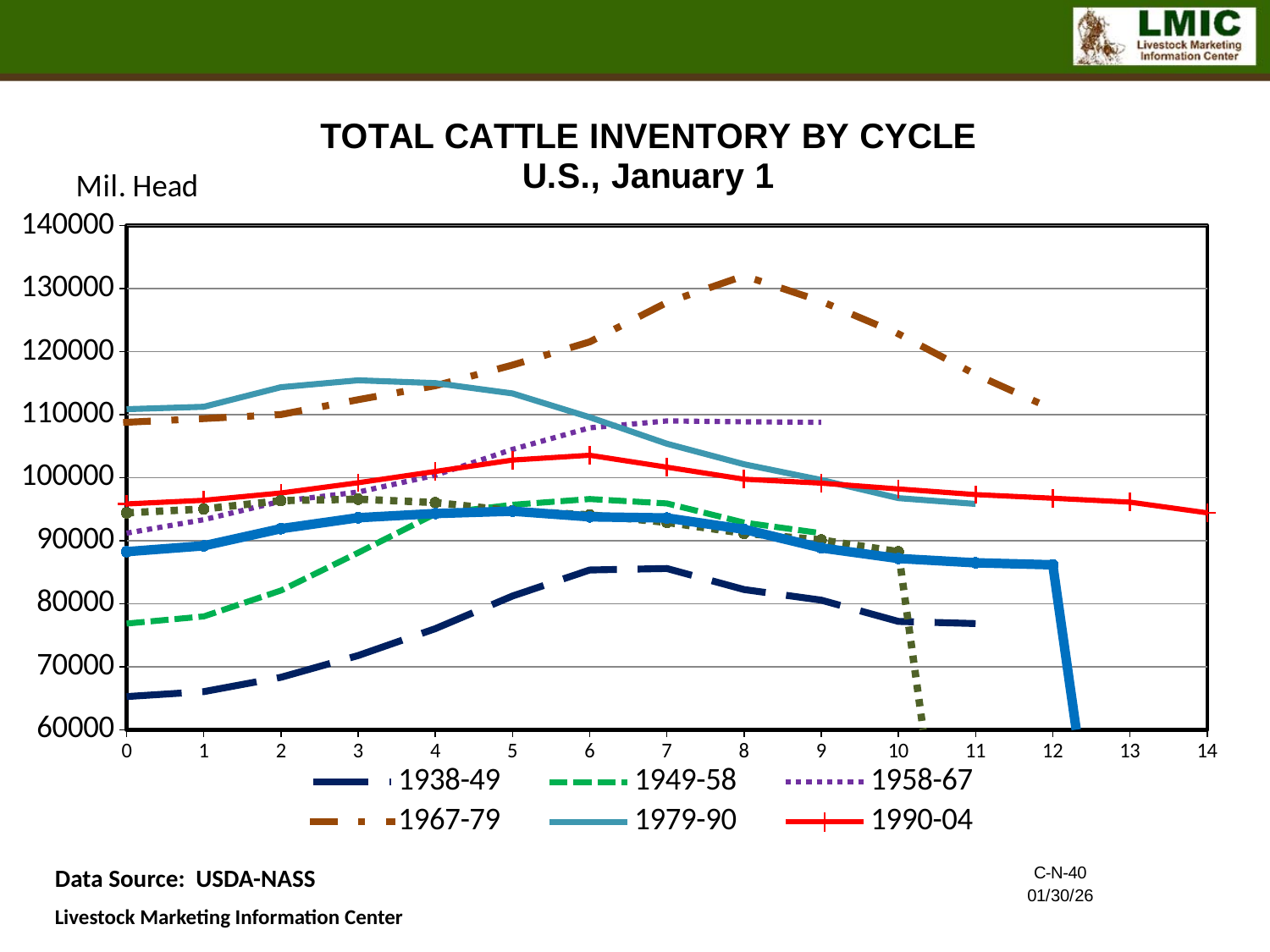
What kind of chart is shown on the slide? line chart Which series has the lowest value at year 0 of the cycle? 1938-49 Does the 1967-79 series rise or fall from year 8 to year 12? fall What is the title of the chart? TOTAL CATTLE INVENTORY BY CYCLE U.S., January 1 Is the value for the 1949-58 series at year 0 greater or less than 80000? less Is the value for the 1990-04 series at year 6 greater or less than 100000? greater Is the value for the 1967-79 series at year 8 greater or less than 120000? greater What data source is cited below the chart? USDA-NASS At year 4, which series has the larger value, 1979-90 or 1990-04? 1979-90 How many series does the legend list? 6 Which series reaches the highest value on the chart? 1967-79